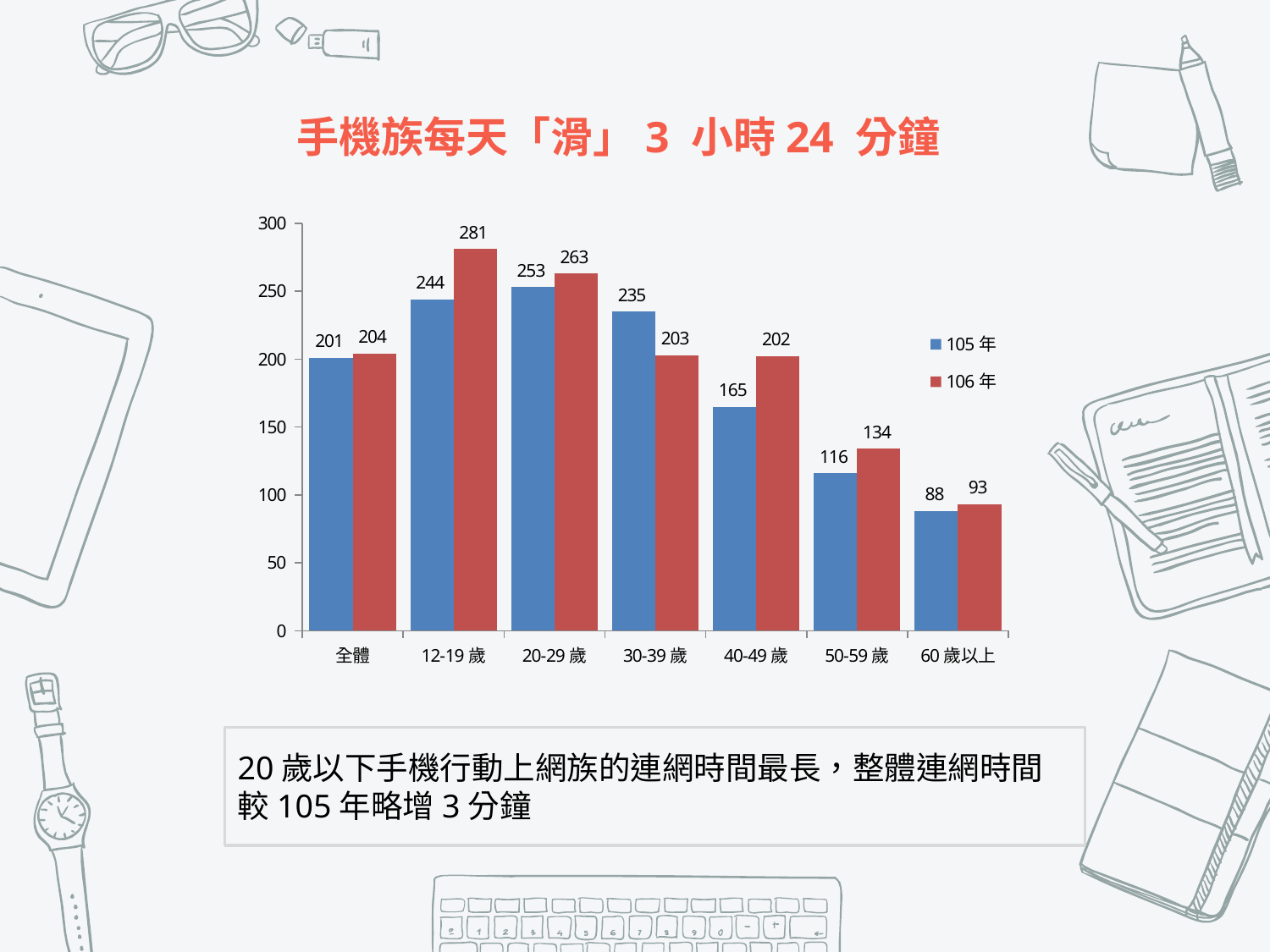
What kind of chart is shown on the slide? Bar chart Which age category has the lowest value in the 105 年 series? 60 歲以上 What is the difference between the 106 年 and 105 年 values for 30-39 歲? -32 What is the value for 全體 in the 106 年 series? 204 What is the value for 40-49 歲 in the 105 年 series? 165 How many age categories are shown on the x axis? 7 Which is larger for 30-39 歲: the 105 年 value or the 106 年 value? 105 年 What is the value for 12-19 歲 in the 106 年 series? 281 What is the difference between the 106 年 and 105 年 values for 40-49 歲? 37 How many series does the legend list? 2 Which is larger for 20-29 歲: the 105 年 value or the 106 年 value? 106 年 Which age category has the highest value in the 106 年 series? 12-19 歲